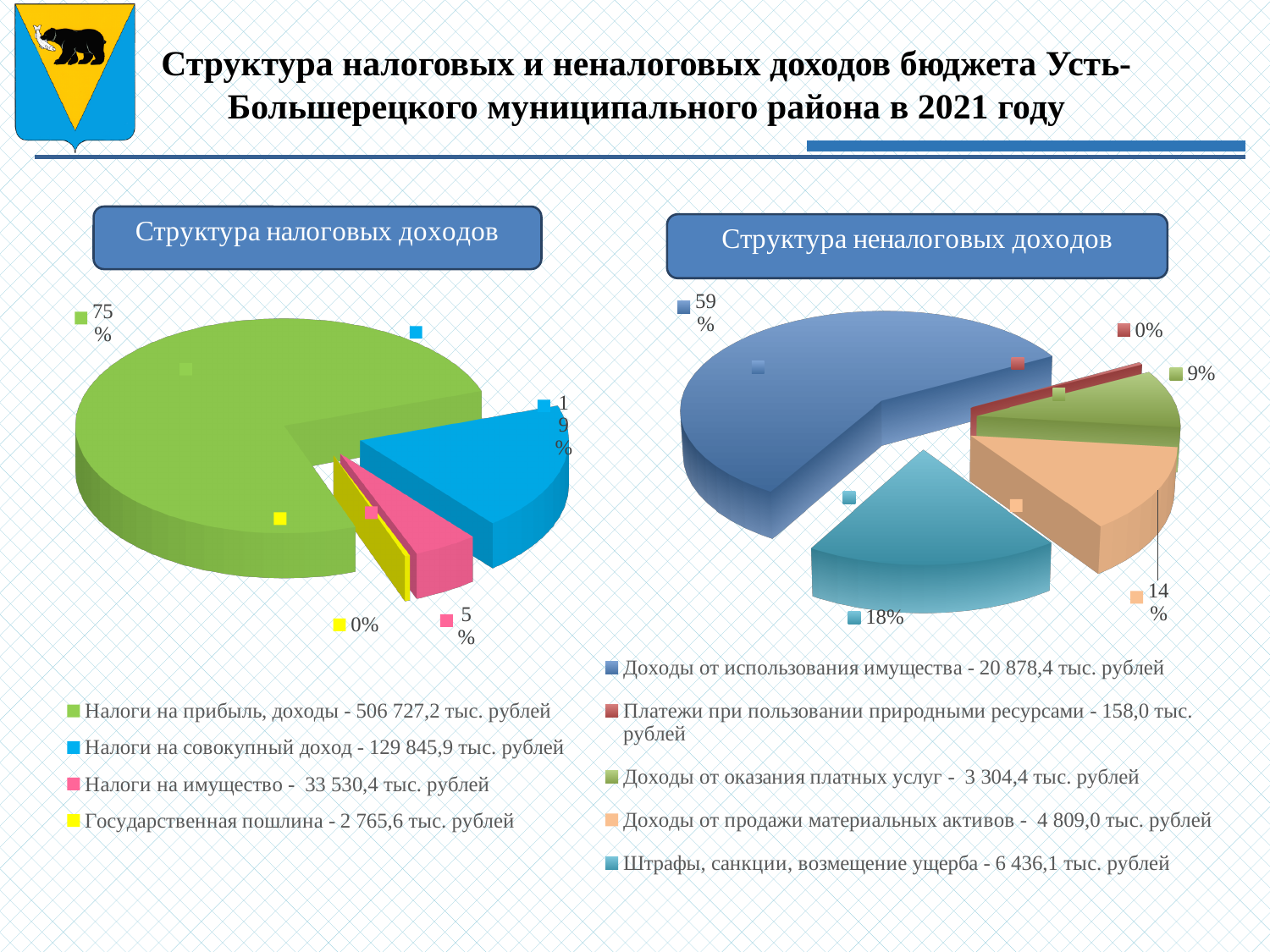
In the "Структура неналоговых доходов" chart, which category has the smallest share? Платежи при пользовании природными ресурсами In the "Структура неналоговых доходов" chart, what amount is given in the legend for "Доходы от продажи материальных активов"? 4 809,0 тыс. рублей In the "Структура неналоговых доходов" chart, what percentage share is shown for "Доходы от использования имущества"? 59% In the "Структура налоговых доходов" chart, which category has the largest share? Налоги на прибыль, доходы In the "Структура неналоговых доходов" chart, how many categories does the legend list? 5 In the "Структура неналоговых доходов" chart, which share is larger: "Доходы от оказания платных услуг" or "Доходы от продажи материальных активов"? Доходы от продажи материальных активов In the "Структура налоговых доходов" chart, what percentage share is shown for "Налоги на совокупный доход"? 19% In the "Структура налоговых доходов" chart, how many categories does the legend list? 4 In the "Структура неналоговых доходов" chart, what percentage share is shown for "Штрафы, санкции, возмещение ущерба"? 18% What type of chart is used for "Структура налоговых доходов"? Pie chart In the "Структура налоговых доходов" chart, what amount is given in the legend for "Налоги на имущество"? 33 530,4 тыс. рублей